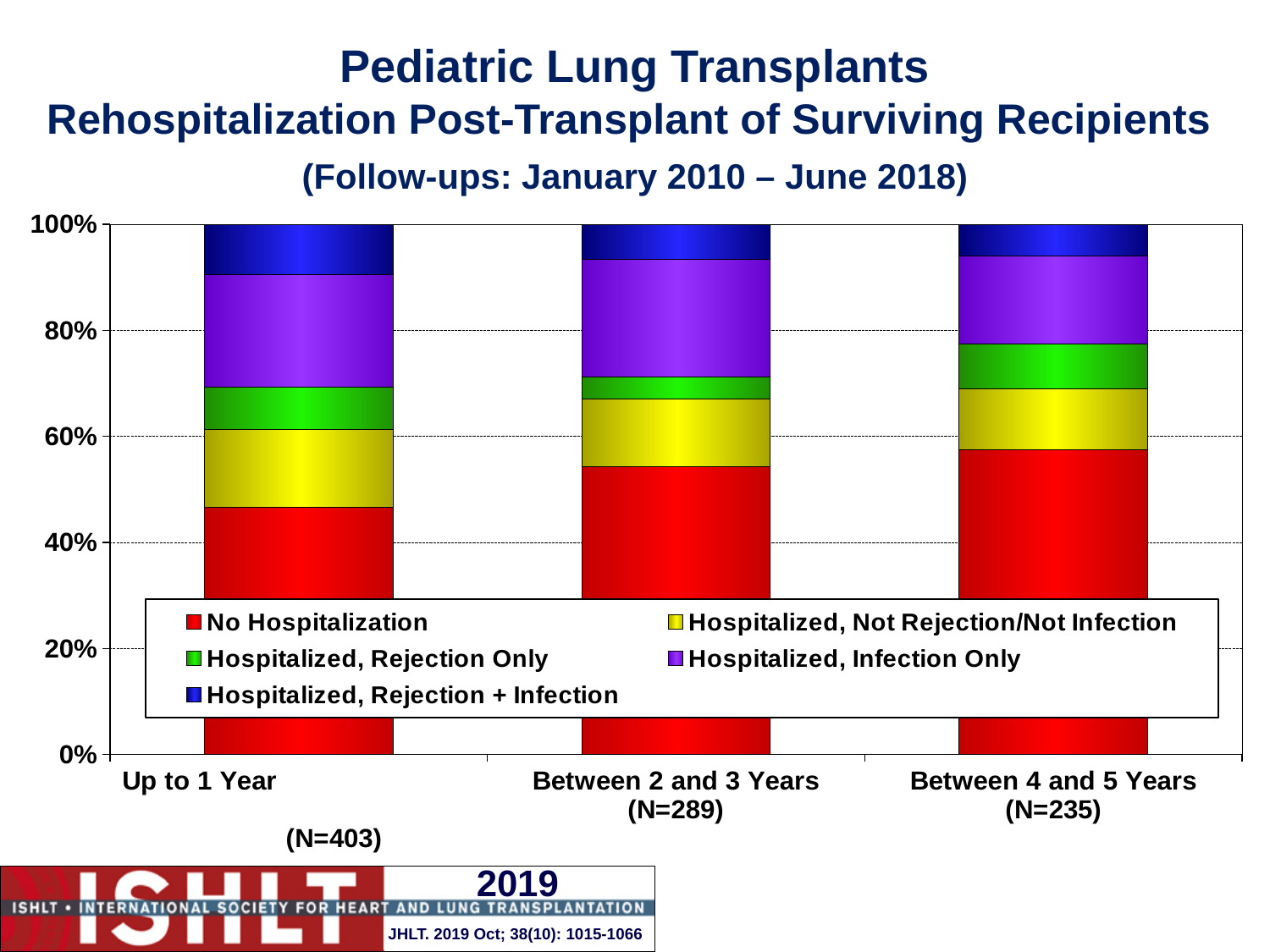
Is the No Hospitalization share for Up to 1 Year greater or less than 60%? less How many series does the legend list? 5 What is the total height of the stacked bar for Up to 1 Year? 100% Which has the larger No Hospitalization share: Up to 1 Year or Between 4 and 5 Years? Between 4 and 5 Years Which colour represents Hospitalized, Infection Only in the legend? Purple Is the No Hospitalization share for Between 2 and 3 Years greater or less than 60%? less Does the No Hospitalization share rise or fall from Up to 1 Year to Between 4 and 5 Years? Rise What kind of chart is shown on the slide? Stacked bar chart Is the No Hospitalization share for Up to 1 Year greater or less than 40%? greater How many follow-up categories are shown on the x axis? 3 What is the N shown for the Between 2 and 3 Years category? N=289